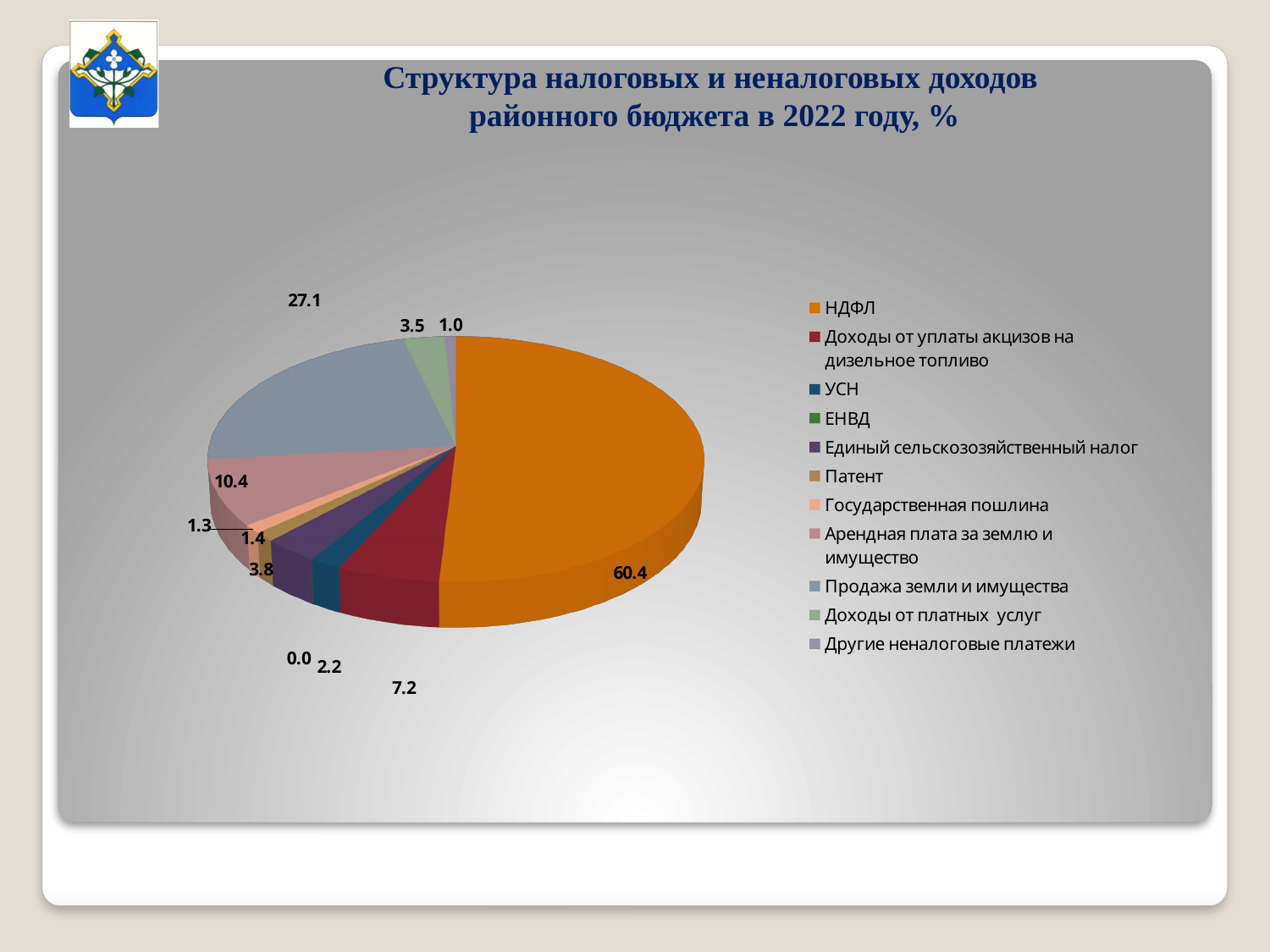
What is the value for Доходы от платных услуг? 3.5 What is the value for Доходы от уплаты акцизов на дизельное топливо? 7.2 Which category has the largest slice? НДФЛ What is the value for Продажа земли и имущества? 27.1 Which category has the smallest value? ЕНВД What is the difference between the values for НДФЛ and Продажа земли и имущества? 33.3 How many categories does the legend list? 11 What is the title of the chart? Структура налоговых и неналоговых доходов районного бюджета в 2022 году, % What kind of chart is shown on the slide? pie chart Which is larger, the value for УСН or the value for Единый сельскозозяйственный налог? Единый сельскозозяйственный налог What is the value for Арендная плата за землю и имущество? 10.4 What is the value for НДФЛ? 60.4